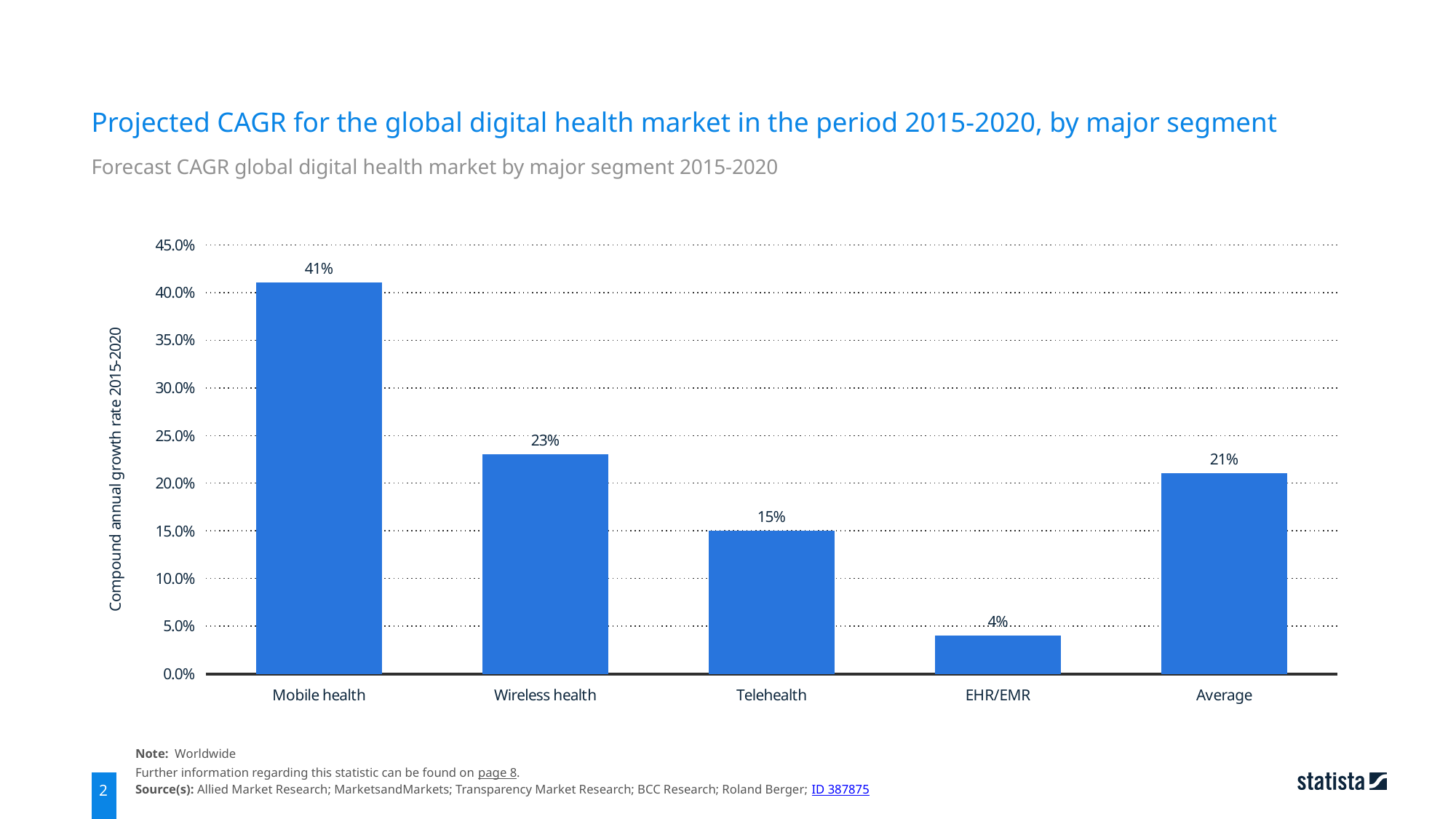
What is the projected CAGR for Telehealth? 15% Which has a higher projected CAGR, Wireless health or Average? Wireless health What kind of chart is shown on the slide? Bar chart Is the value for Telehealth greater or less than 20.0%? less Which segment has the lowest projected CAGR? EHR/EMR What is the difference between the CAGR for Mobile health and Wireless health? 18% Which segment has the highest projected CAGR? Mobile health How many categories are shown on the x axis? 5 What is the difference between the CAGR for Average and EHR/EMR? 17% What is the projected CAGR for Mobile health? 41% What is the projected CAGR for EHR/EMR? 4% What is the label of the y axis? Compound annual growth rate 2015-2020